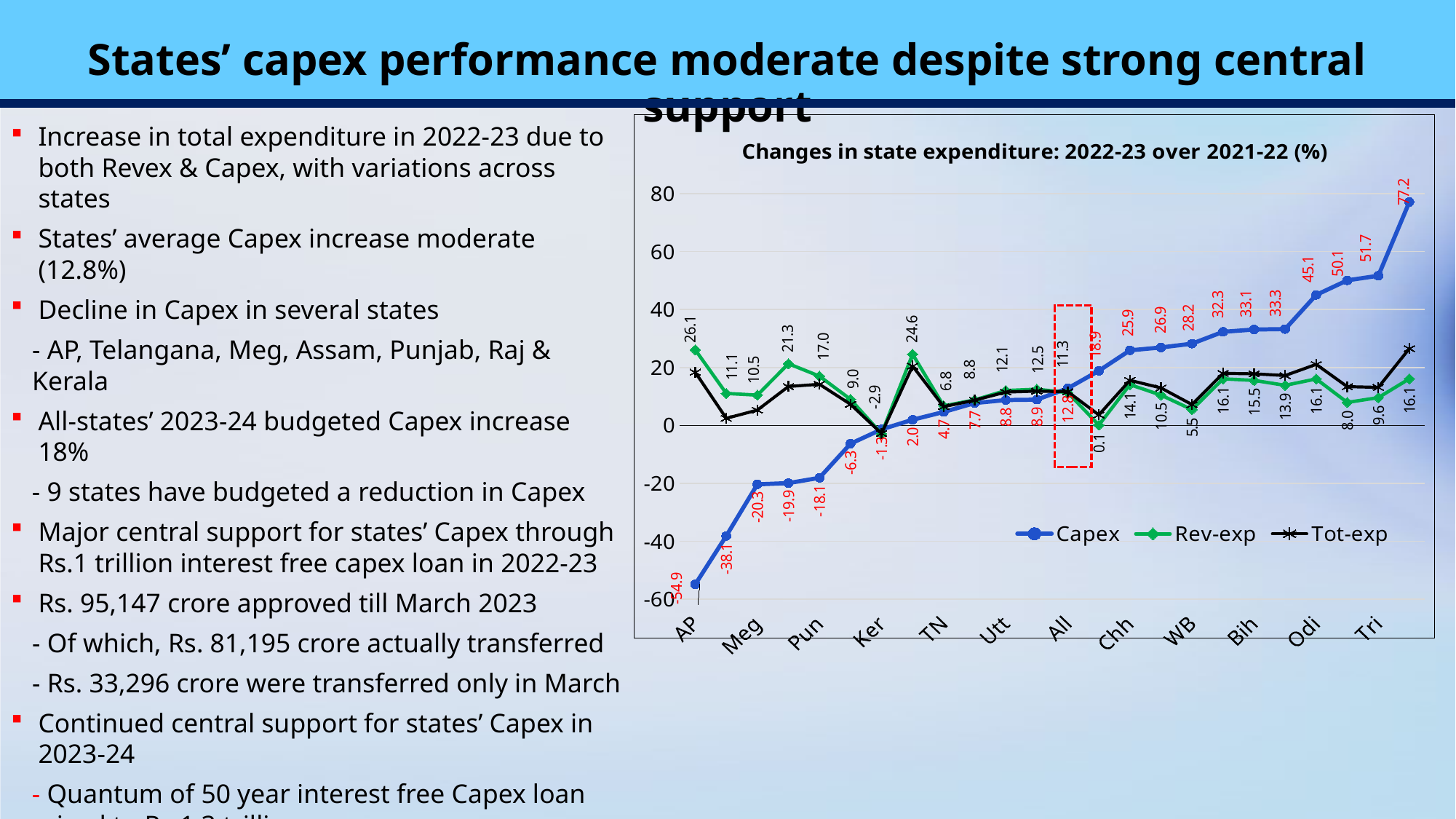
How many series does the legend of the chart list? 3 What is the Capex value for AP? -54.9 What is the highest Capex value printed on the chart? 77.2 What is the Capex value for Odi? 45.1 What is the difference between the Capex values for Tri and Odi? 6.6 What type of chart is shown on the slide? line chart What is the Capex value for Ker? -1.3 What is the Capex value for Tri? 51.7 Which state has the lowest Capex value in the chart? AP What is the title of the chart? Changes in state expenditure: 2022-23 over 2021-22 (%) Which has the larger Capex value, Chh or WB? WB What is the Capex value for All (all states)? 12.8